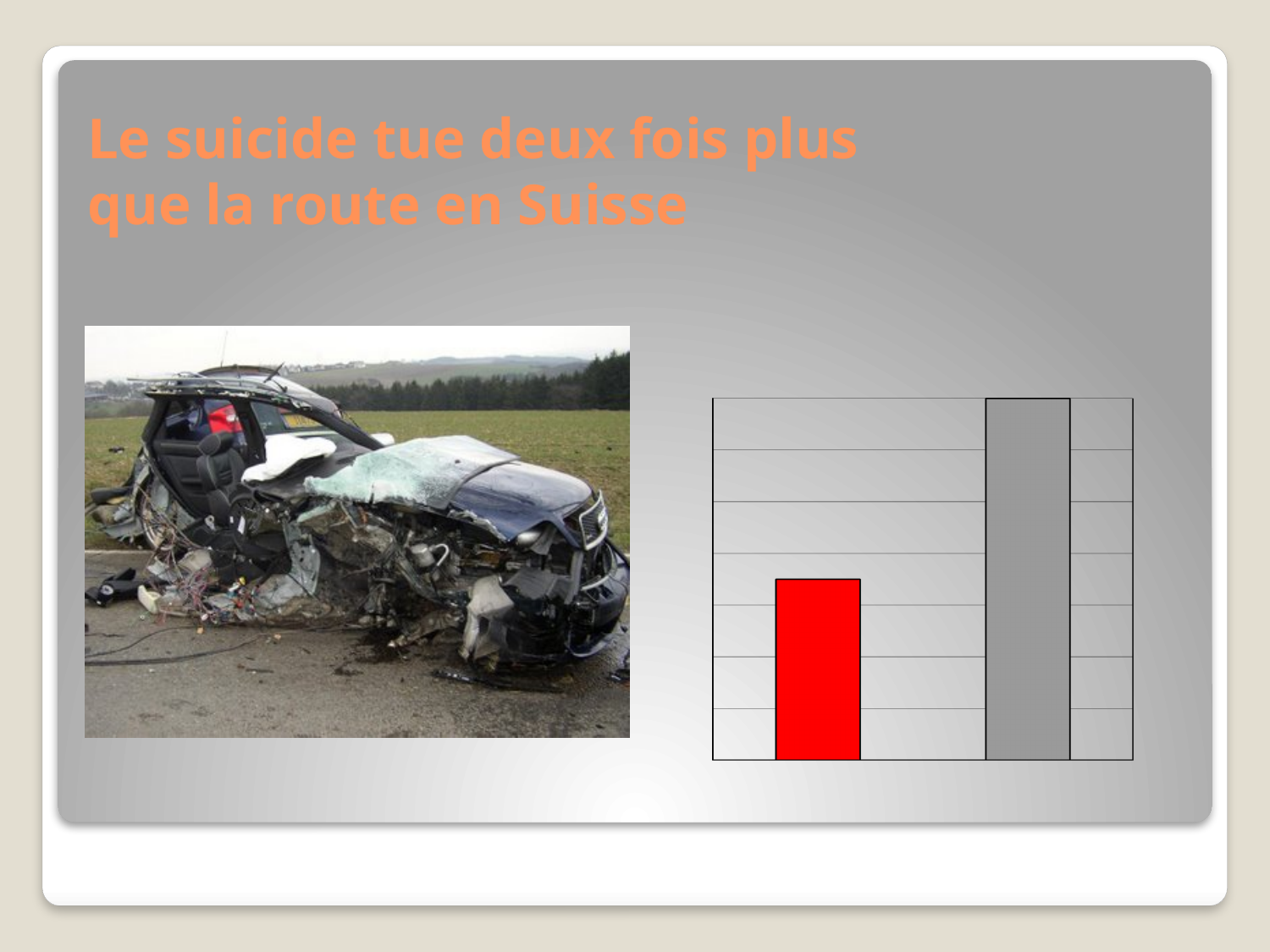
What kind of chart is shown on the slide? bar chart Which bar in the chart is taller, the red bar or the grey bar? the grey bar Which bar in the chart is the shortest? the red bar Does the chart on the slide display a legend? No How many bars does the chart on the slide show? 2 What colour is the taller bar in the chart? grey